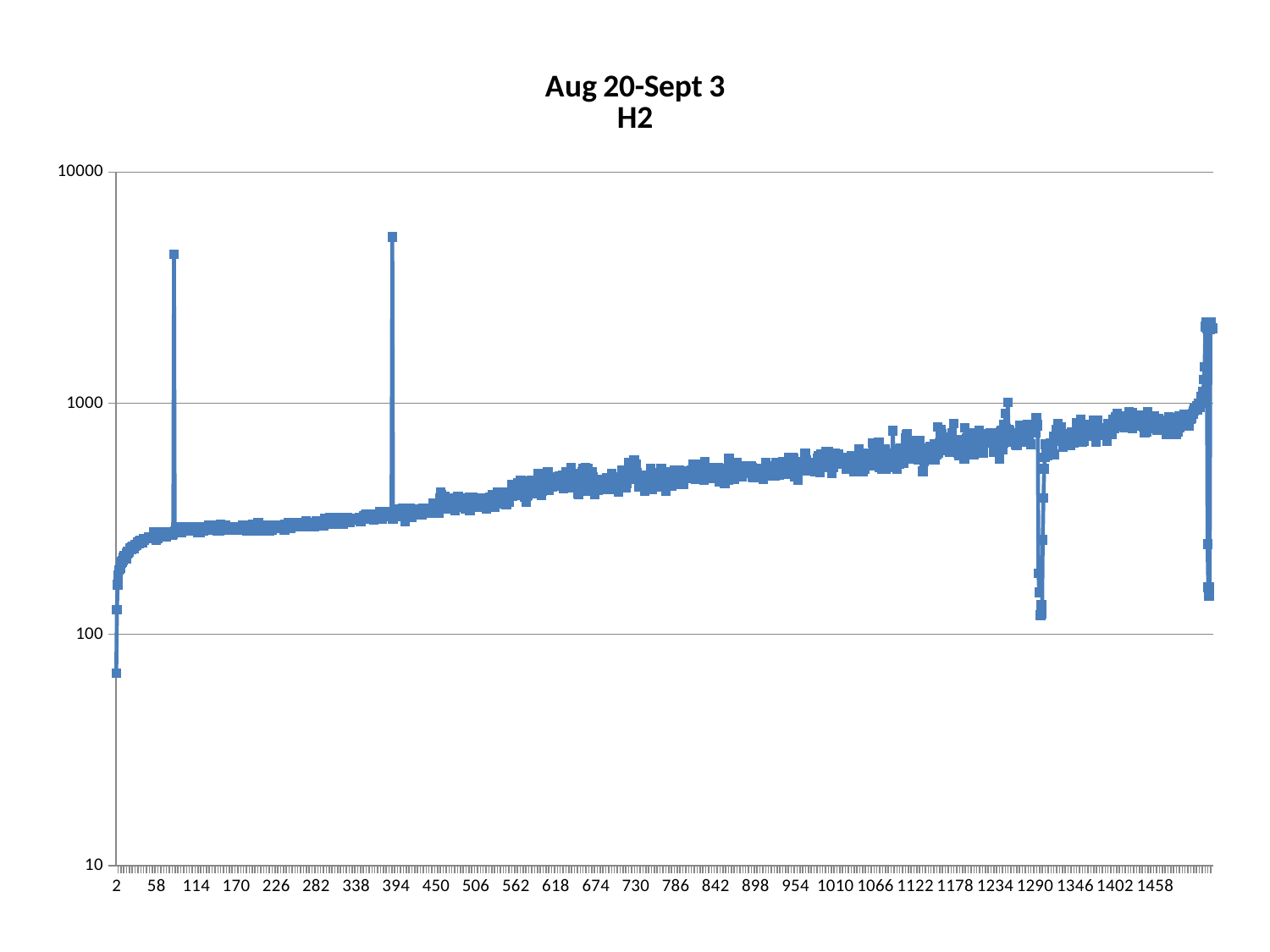
What is the title of the chart? Aug 20-Sept 3 H2 What is the lowest tick value shown on the y axis? 10 What is the highest tick value shown on the y axis? 10000 How many data series are plotted on the chart? 1 Do the plotted values generally rise or fall from left to right along the x axis? rise Is the value at x = 730 greater or less than 1000? less Is the value at x = 1458 greater or less than 100? greater Is the value at x = 1290 greater or less than 1000? less What kind of chart is shown on the slide? line chart